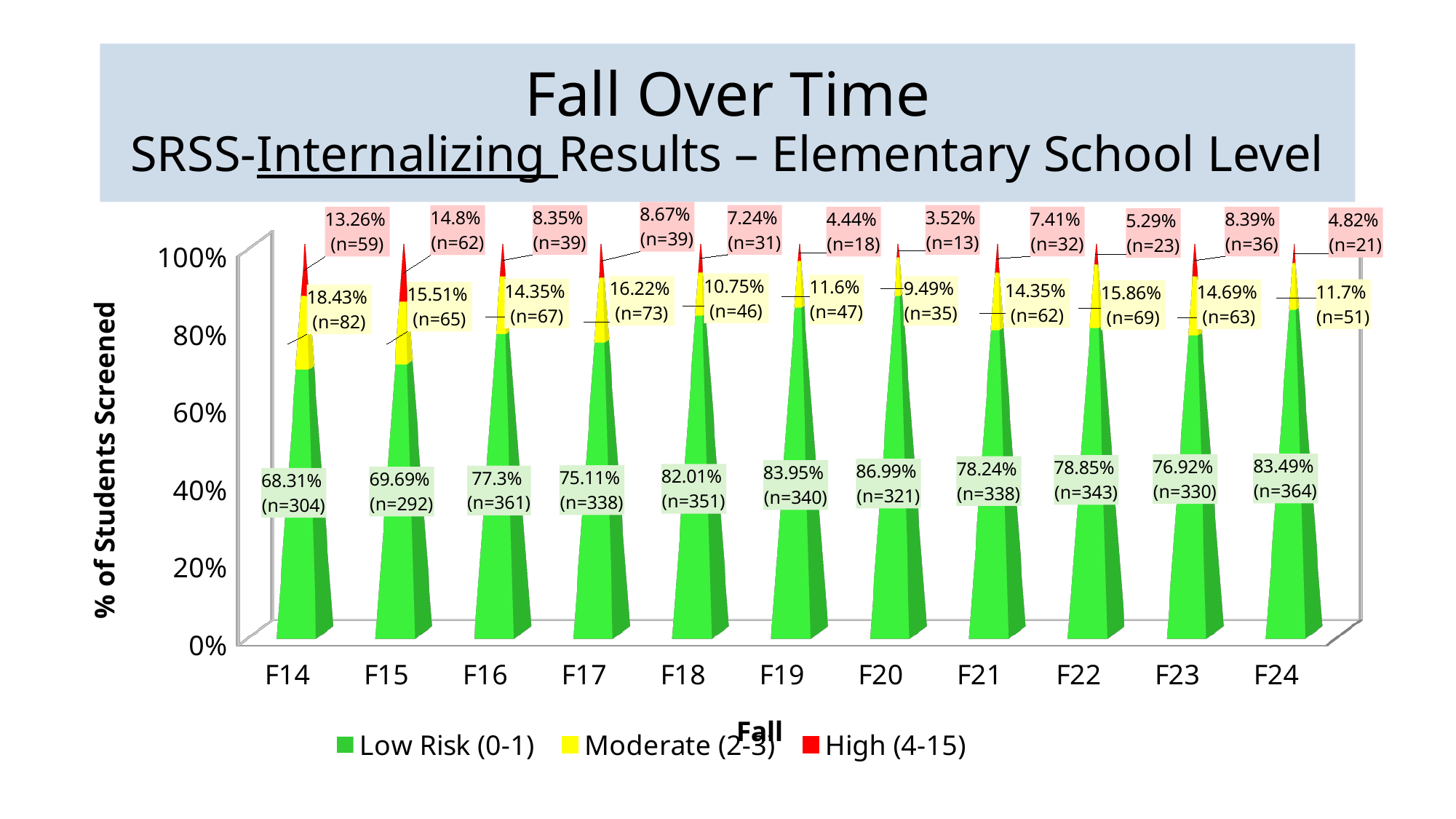
What is the Moderate (2-3) percentage for F17? 16.22% How many fall terms are shown on the x axis? 11 How many students were in the Low Risk (0-1) group in F24? n=364 Which is larger, the High (4-15) percentage for F14 or for F16? F14 Which fall has the lowest High (4-15) percentage? F20 What kind of chart is shown on the slide? Stacked bar chart Which fall has the highest Low Risk (0-1) percentage? F20 How many series does the legend list? 3 What is the Low Risk (0-1) percentage for F20? 86.99% Which fall has the lowest Low Risk (0-1) percentage? F14 What is the difference in Low Risk (0-1) percentage between F20 and F14? 18.68 percentage points What is the High (4-15) percentage for F15? 14.8%